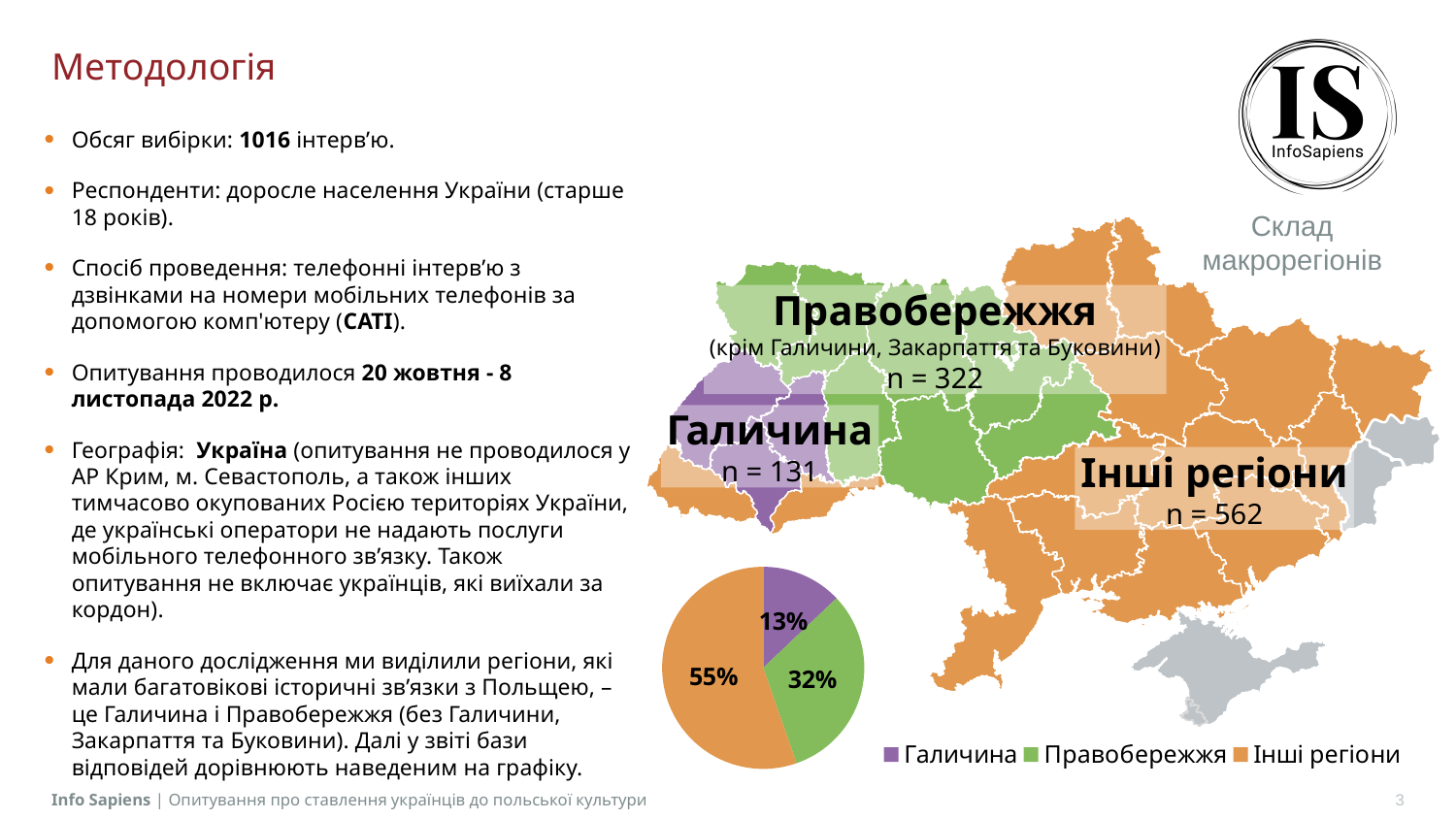
Which slice is larger in the pie chart: Галичина or Правобережжя? Правобережжя What share of the pie chart does Галичина account for? 13% Which region has the smallest slice in the pie chart? Галичина What share of the pie chart does Інші регіони account for? 55% What share of the pie chart does Правобережжя account for? 32% What type of chart is shown at the bottom of the slide? Pie chart What is the difference in percentage points between the Інші регіони slice and the Правобережжя slice? 23 How many slices does the pie chart have? 3 How many entries does the pie chart legend list? 3 What colour is the Інші регіони slice in the pie chart? Orange Which region has the largest slice in the pie chart? Інші регіони What is the difference in percentage points between the Правобережжя slice and the Галичина slice? 19